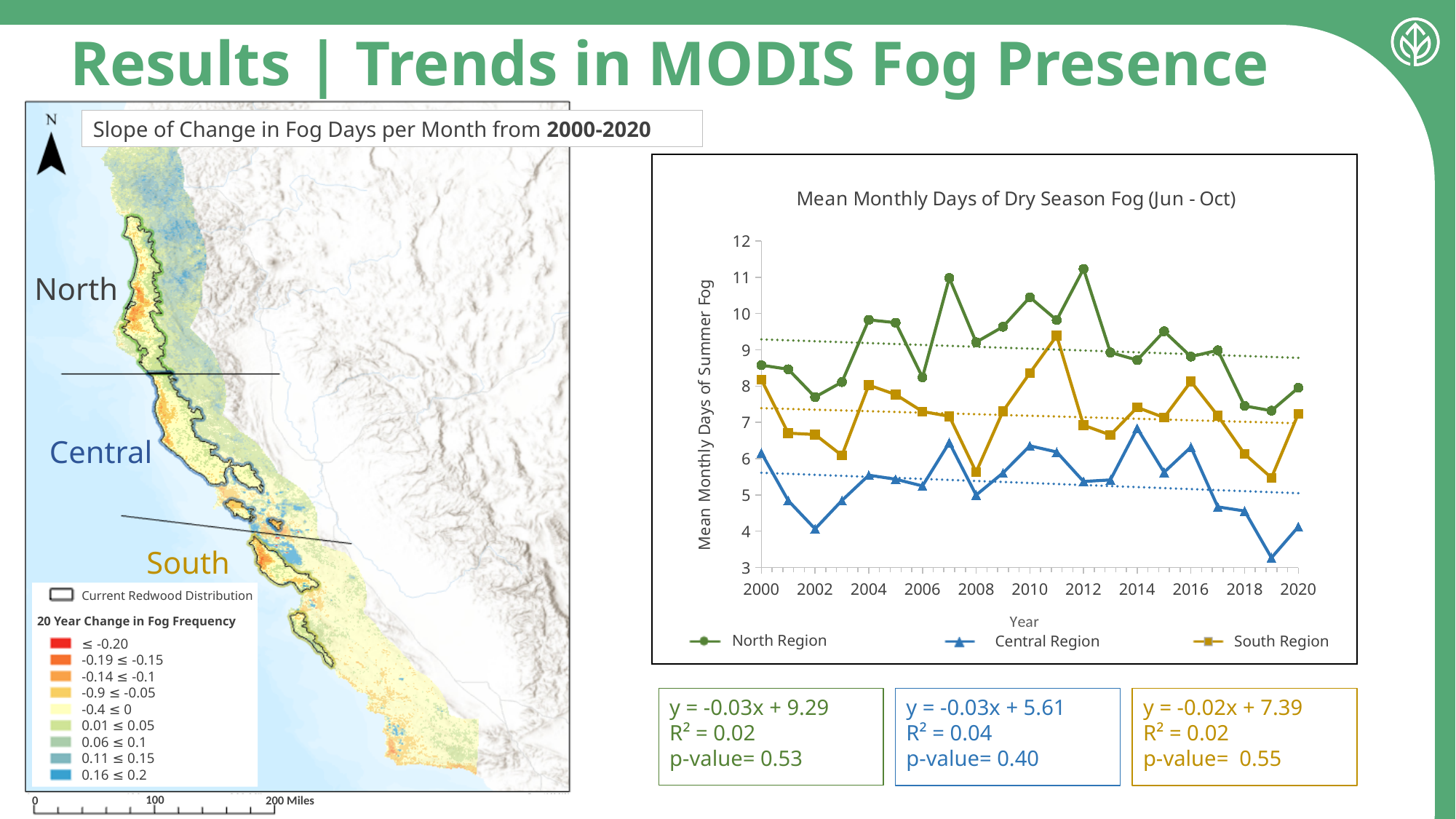
In the 'Mean Monthly Days of Dry Season Fog (Jun - Oct)' chart, in which year does the Central Region reach its lowest value? 2019 In the 'Mean Monthly Days of Dry Season Fog (Jun - Oct)' chart, which is larger in 2011: the South Region value or the Central Region value? South Region In the 'Mean Monthly Days of Dry Season Fog (Jun - Oct)' chart, is the North Region value for 2012 greater or less than 10? greater In the 'Mean Monthly Days of Dry Season Fog (Jun - Oct)' chart, do the dotted trend lines for the three regions rise or fall from 2000 to 2020? fall In the 'Mean Monthly Days of Dry Season Fog (Jun - Oct)' chart, is the South Region value for 2011 greater or less than 9? greater In the 'Mean Monthly Days of Dry Season Fog (Jun - Oct)' chart, which region has the lowest values across the whole period? Central Region What kind of chart is shown on the right side of the slide? line chart In the 'Mean Monthly Days of Dry Season Fog (Jun - Oct)' chart, which region has the highest values across the whole period? North Region What is the y-axis label of the 'Mean Monthly Days of Dry Season Fog (Jun - Oct)' chart? Mean Monthly Days of Summer Fog How many series does the legend of the 'Mean Monthly Days of Dry Season Fog (Jun - Oct)' chart list? 3 In the 'Mean Monthly Days of Dry Season Fog (Jun - Oct)' chart, is the South Region value for 2008 greater or less than 6? less